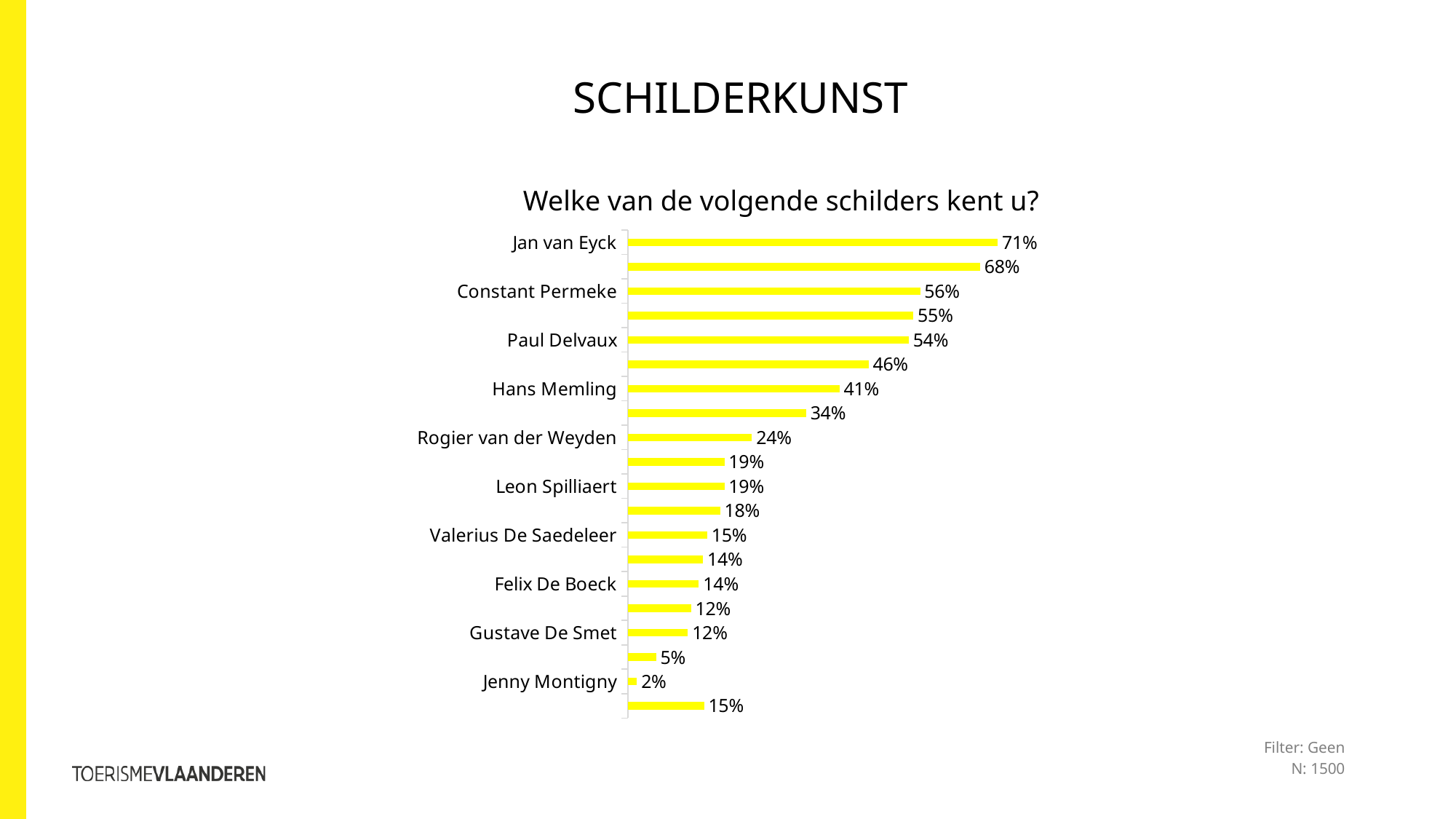
What is the difference in percentage points between Paul Delvaux and Hans Memling? 13 What type of chart is shown on the slide? Bar chart Which painter has the highest value in the chart? Jan van Eyck What is the value shown for Constant Permeke? 56% What percentage is shown for Jenny Montigny? 2% What is the value for Rogier van der Weyden? 24% What is the difference in percentage points between Jan van Eyck and Constant Permeke? 15 Which labelled painter has the lowest value in the chart? Jenny Montigny What percentage is shown for Hans Memling? 41% What question is shown as the chart title? Welke van de volgende schilders kent u? Which has a higher value, Hans Memling or Rogier van der Weyden? Hans Memling What percentage of respondents know Jan van Eyck? 71%